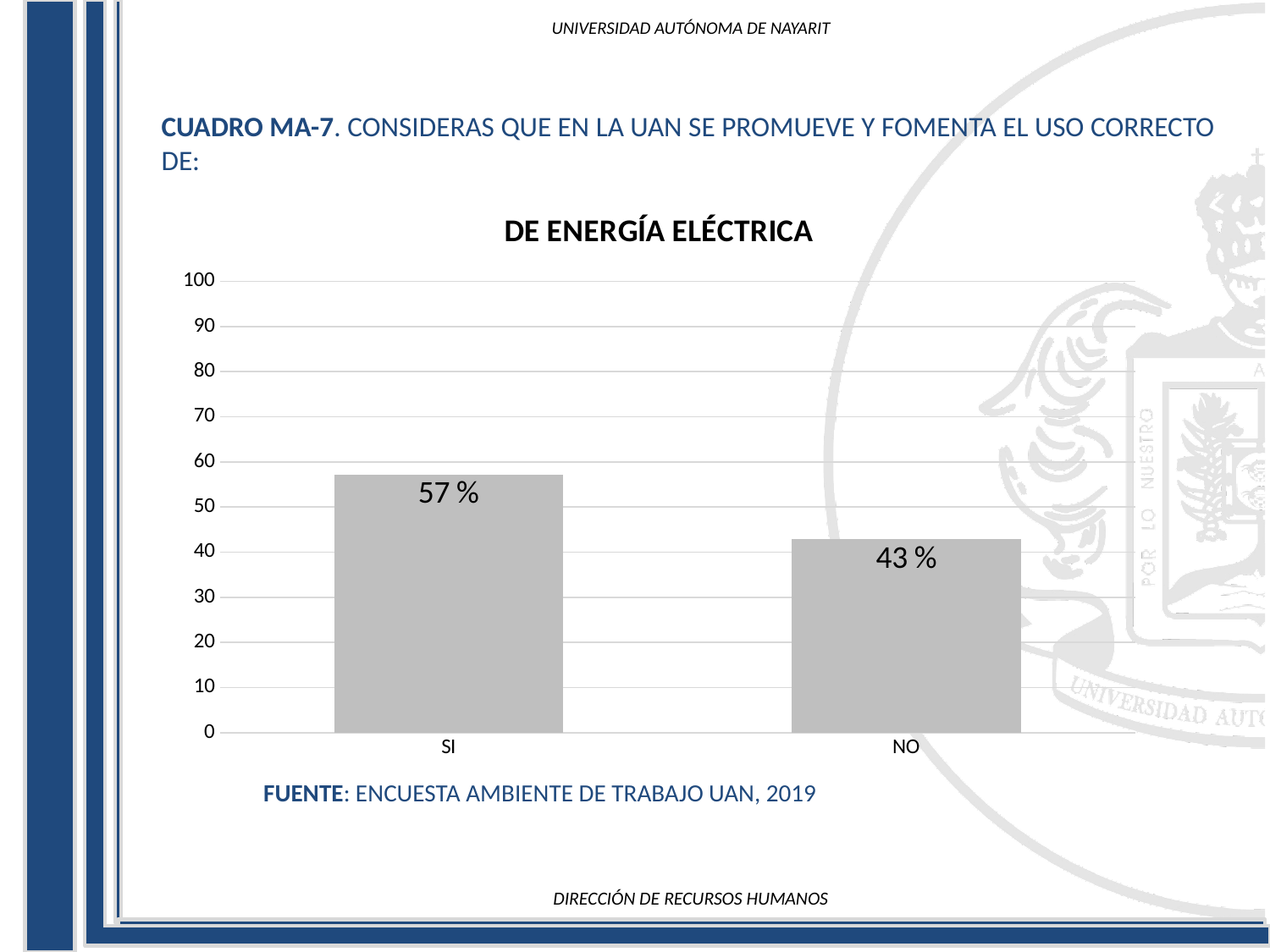
What is the highest value shown on the y axis? 100 What is the difference between the values for SI and NO? 14 % How many categories are shown on the x axis? 2 Which category has the lowest value? NO What is the value for SI? 57 % What is the value for NO? 43 % Is the value for NO greater or less than 50? less What is the title of the chart? DE ENERGÍA ELÉCTRICA Which is larger, the value for SI or the value for NO? SI Is the value for SI greater or less than 50? greater Which category has the highest value? SI What kind of chart is shown on the slide? bar chart